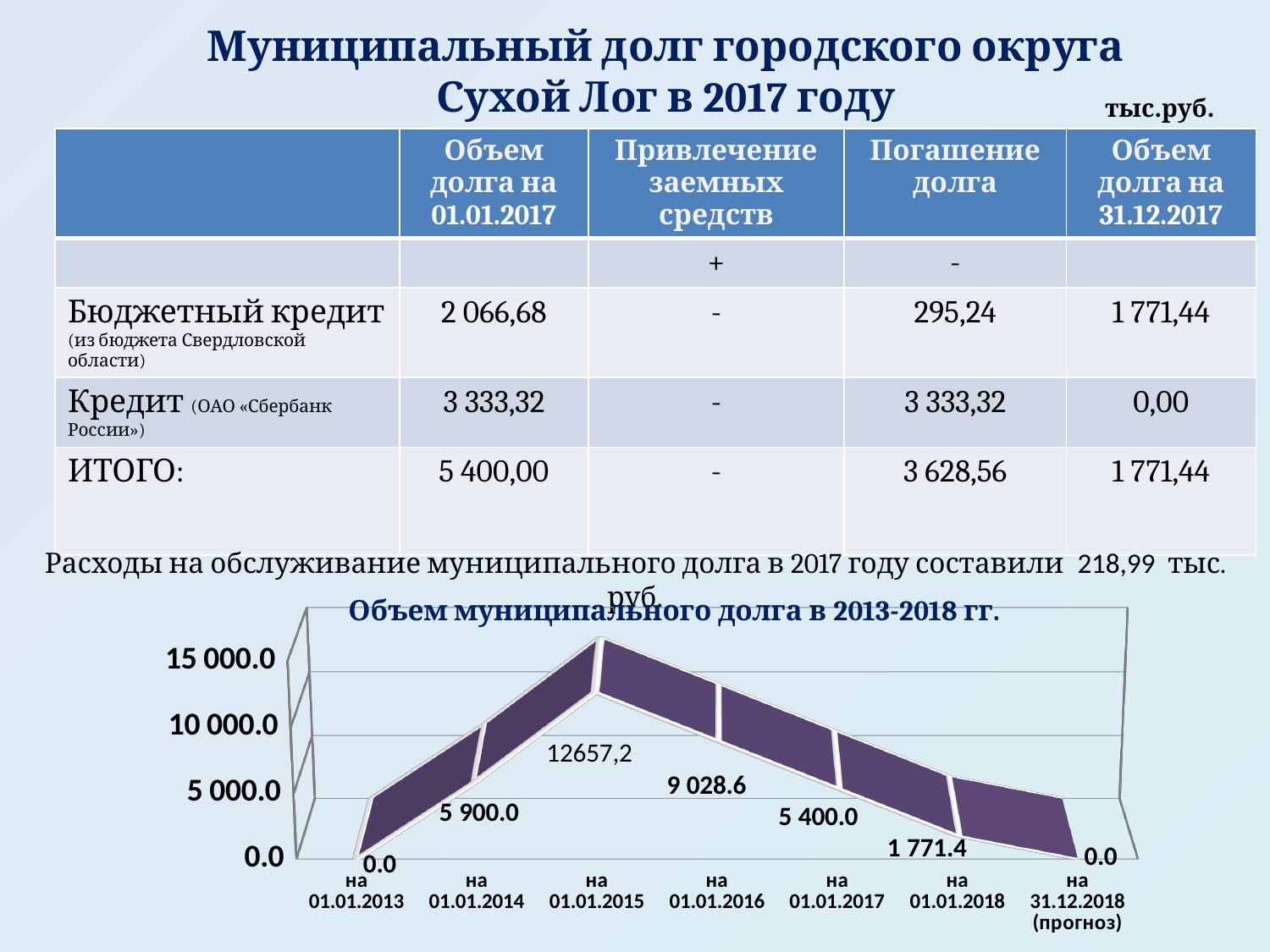
Which is larger on the chart: the debt on 01.01.2016 or on 01.01.2017? 01.01.2016 What is the title of the chart on the slide? Объем муниципального долга в 2013-2018 гг. What is the value of municipal debt on 01.01.2014 according to the chart? 5 900.0 Is the value for 01.01.2016 on the chart greater or less than 10 000.0? less On which date does the chart show the highest municipal debt? на 01.01.2015 How does the municipal debt change on the chart from 01.01.2015 to 31.12.2018? it falls What is the value of municipal debt on 01.01.2015 according to the chart? 12657,2 What is the value of municipal debt on 01.01.2018 according to the chart? 1 771.4 What is the value of municipal debt on 01.01.2016 according to the chart? 9 028.6 What type of chart is shown at the bottom of the slide? line chart How many data points are plotted on the chart? 7 What is the difference between the debt on 01.01.2017 and on 01.01.2018 on the chart? 3 628.6